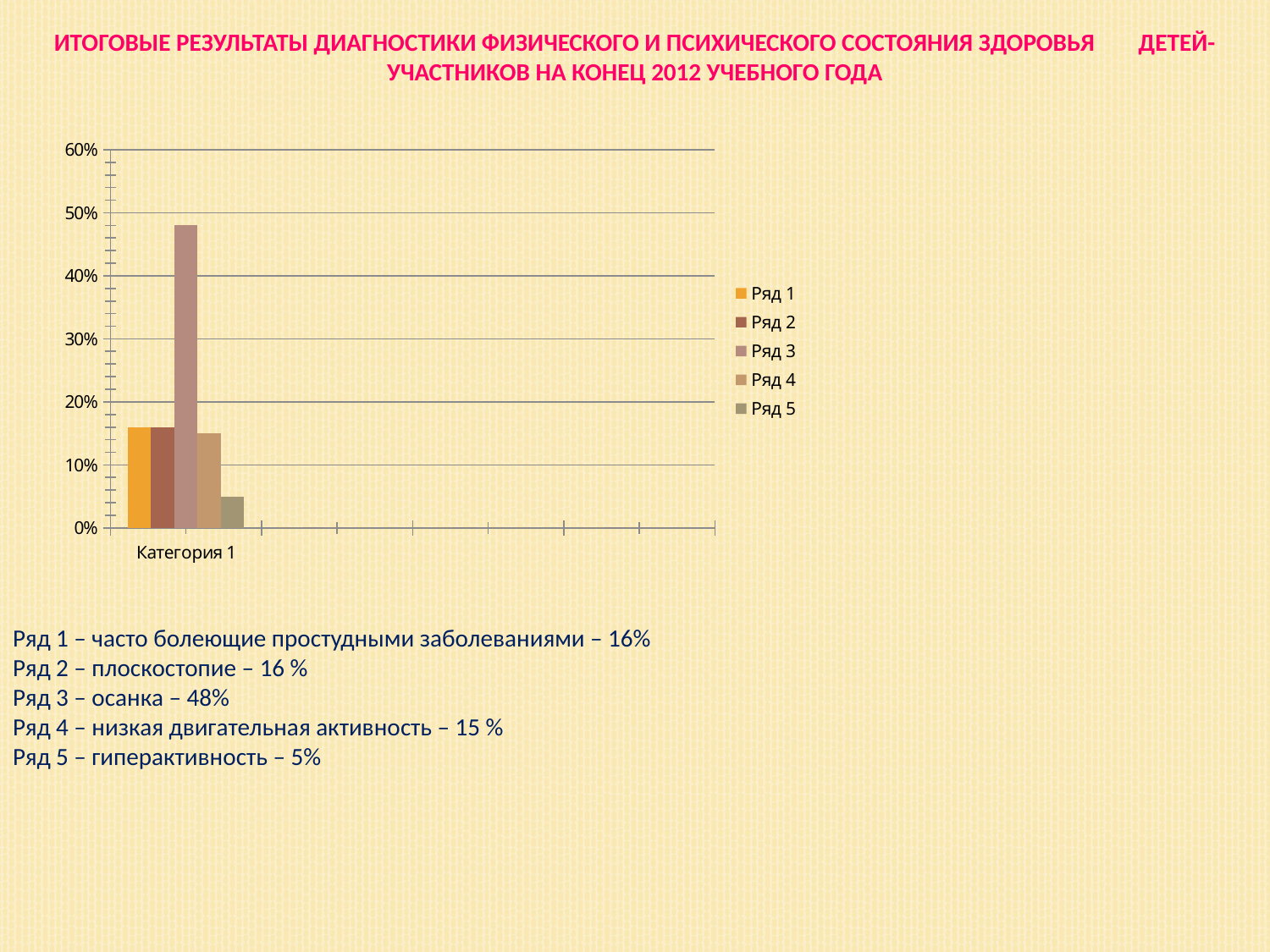
What kind of chart is shown on the slide? bar chart What is the value for Ряд 4 in the chart? 15 % Is the value for Ряд 3 greater or less than 40%? greater Which series has the highest value in the chart? Ряд 3 What is the value for Ряд 5 in the chart? 5% Is the value for Ряд 5 greater or less than 10%? less What is the difference between the values for Ряд 3 and Ряд 4? 33 percentage points How many categories are shown on the x axis of the chart? 1 Which series has the lowest value in the chart? Ряд 5 What is the value for Ряд 3 in the chart? 48% Which is larger, the value for Ряд 3 or the value for Ряд 1? Ряд 3 How many series does the legend list? 5